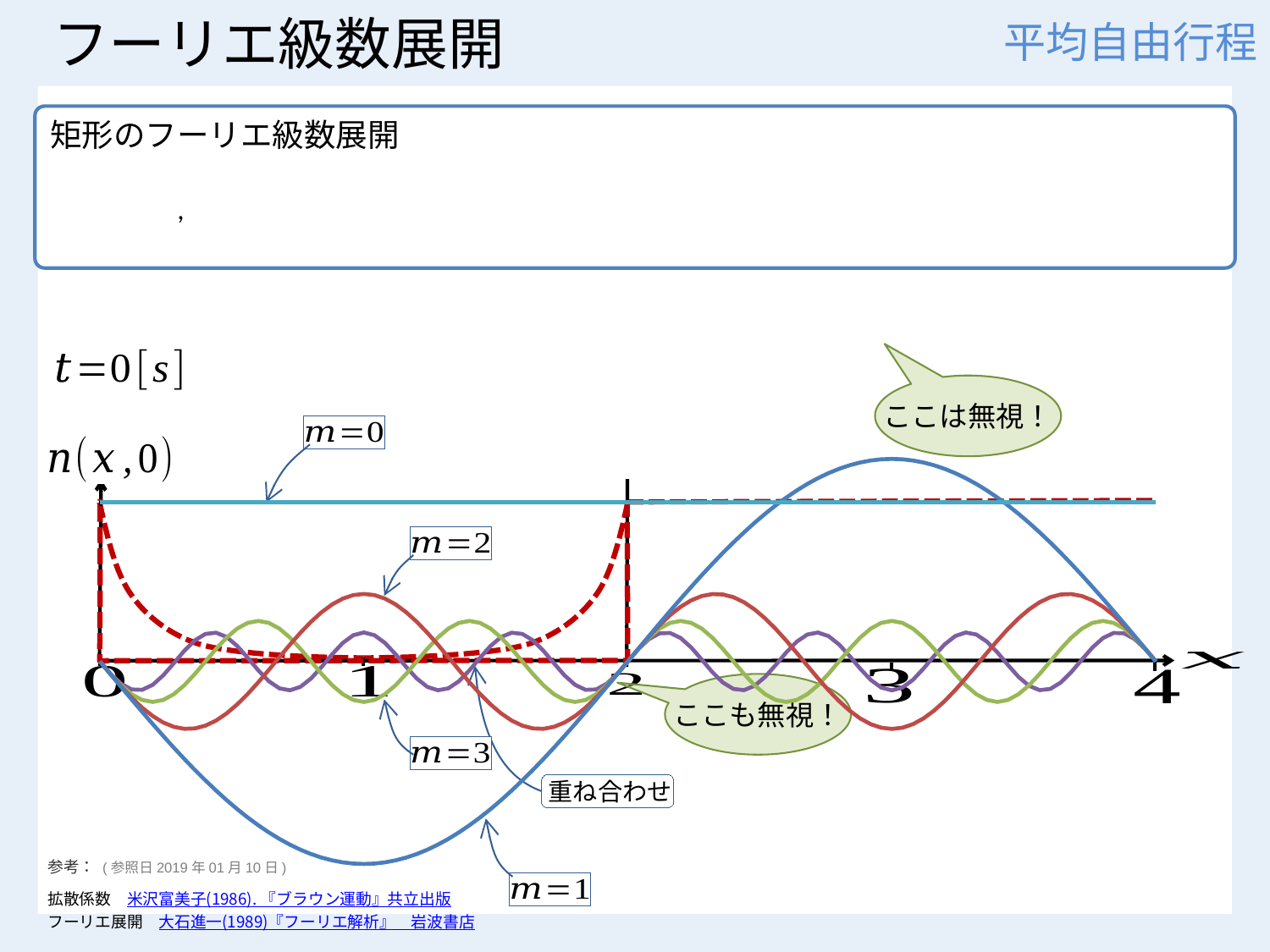
Does the m=1 curve rise or fall as x goes from 0 to 1? fall Does the m=1 curve rise or fall as x goes from 2 to 3? rise At x=1, which is larger, the value of the m=1 curve or the m=2 curve? m=2 Which of the curves m=1, m=2 and m=3 oscillates the most times between x=0 and x=4? m=3 What kind of chart is shown on the slide? line chart At x=3, which is larger, the value of the m=1 curve or the m=2 curve? m=1 Which labeled curve has the largest amplitude in the plot? m=1 How many labeled curves (m=0, m=1, m=2, m=3 and 重ね合わせ) are drawn in the plot? 5 How many tick labels are shown on the x axis of the plot? 5 What is the label of the red dashed curve in the plot? 重ね合わせ Which labeled curve in the plot is a constant horizontal line? m=0 What is the largest tick label on the x axis of the plot? 4